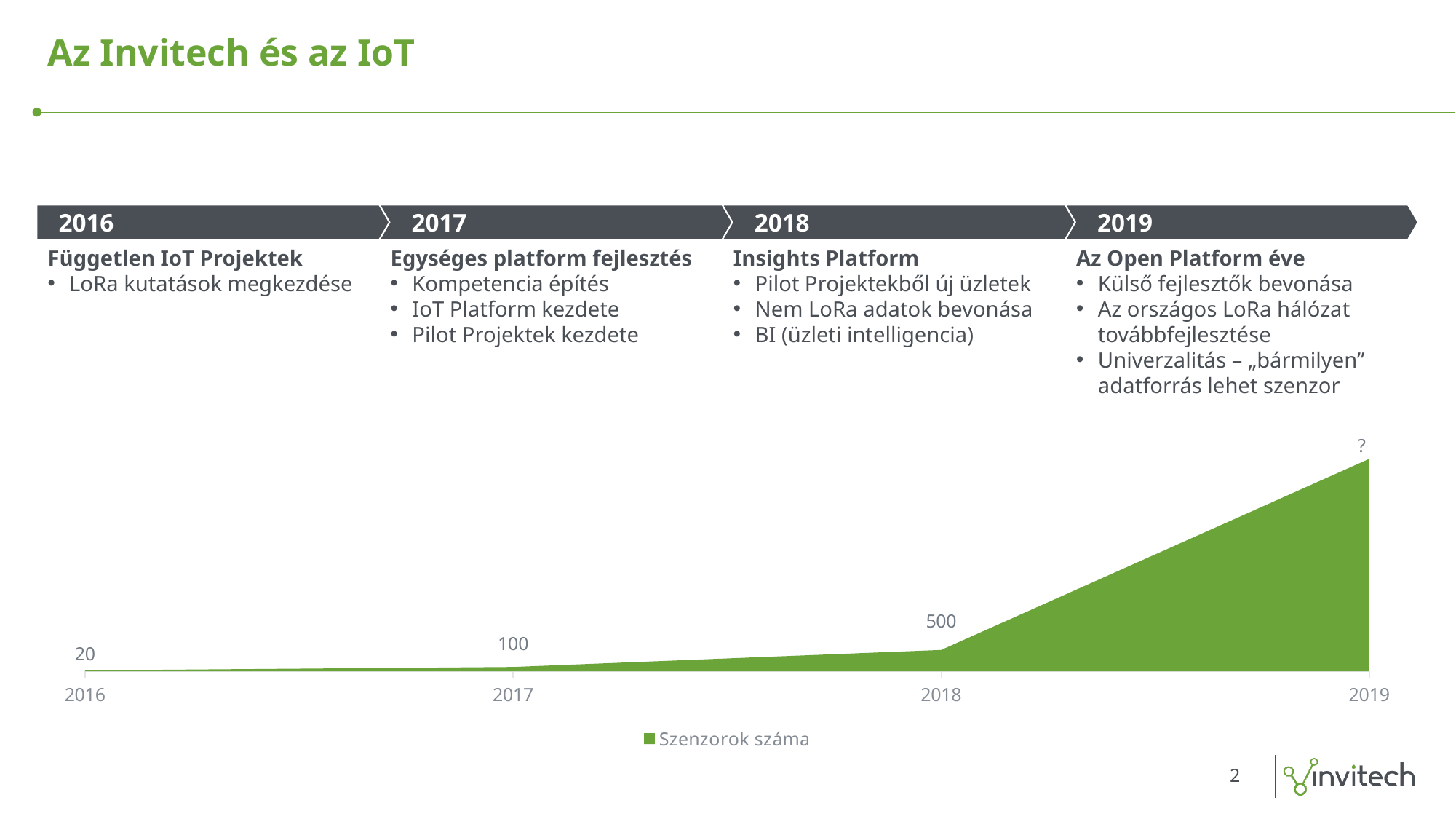
Do the values rise or fall from 2016 to 2019? Rise What is the value for 2017 in the chart? 100 What is the difference between the values for 2017 and 2016? 80 What data label is shown for 2019 in the chart? ? Which year has the highest value in the chart? 2019 What kind of chart is shown on the slide? Area chart How many years are shown on the x axis of the chart? 4 Which year has the lowest labelled value in the chart? 2016 What is the value for 2016 in the chart? 20 What is the difference between the values for 2018 and 2017? 400 What is the value for 2018 in the chart? 500 Which is larger, the value for 2018 or the value for 2017? 2018